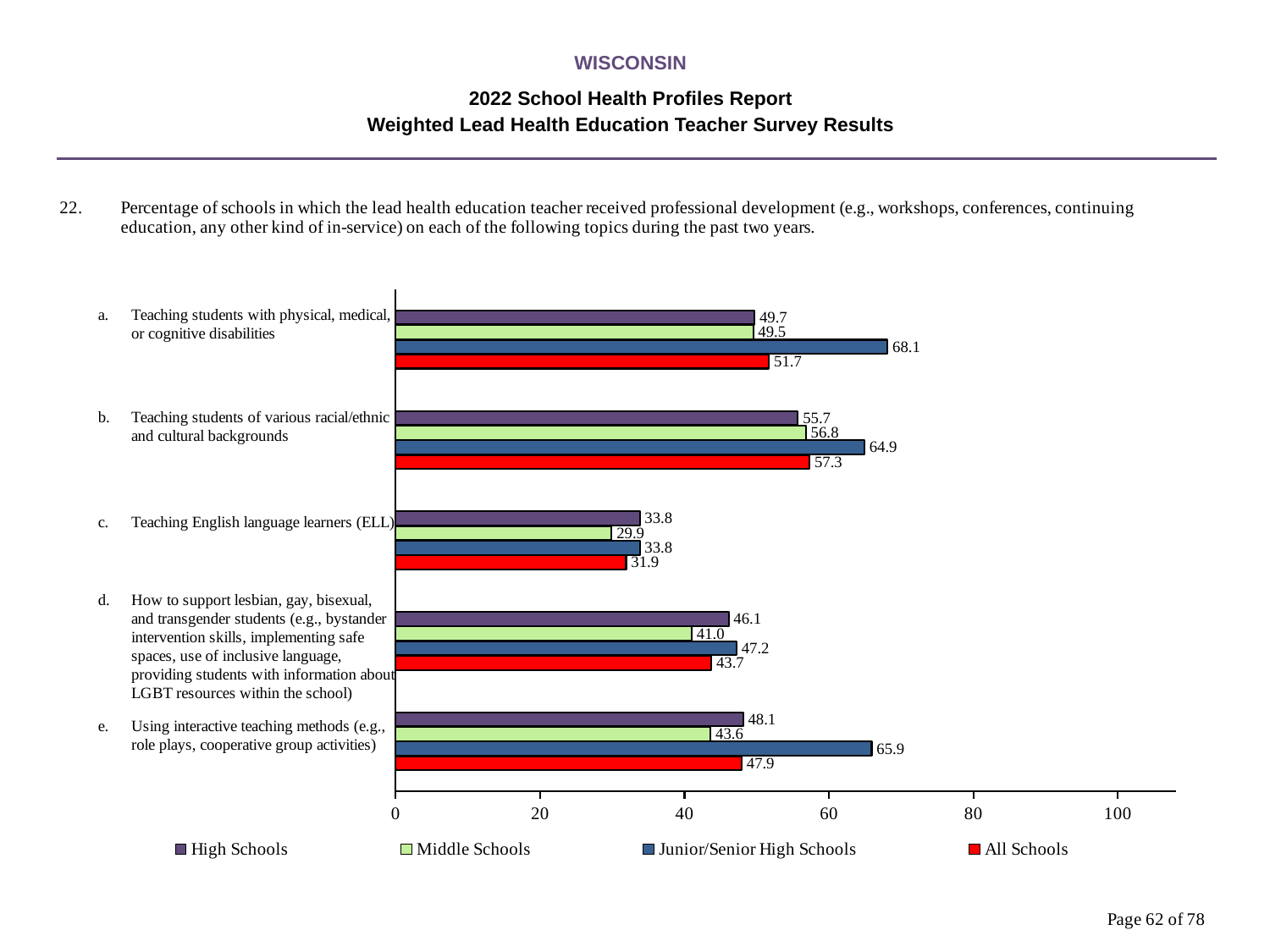
What is the value for Junior/Senior High Schools for topic a, teaching students with physical, medical, or cognitive disabilities? 68.1 Which topic has the highest value for Junior/Senior High Schools? Teaching students with physical, medical, or cognitive disabilities What is the value for Middle Schools for topic d, how to support lesbian, gay, bisexual, and transgender students? 41.0 For topic b, teaching students of various racial/ethnic and cultural backgrounds, which is larger: the High Schools value or the Middle Schools value? Middle Schools Which topic has the lowest value for All Schools? Teaching English language learners (ELL) How many topics are shown on the chart? 5 What is the difference between the Junior/Senior High Schools value and the Middle Schools value for topic e, using interactive teaching methods? 22.3 What is the value for High Schools for topic e, using interactive teaching methods? 48.1 What is the value for All Schools for topic c, teaching English language learners (ELL)? 31.9 Is the All Schools value for topic b, teaching students of various racial/ethnic and cultural backgrounds, greater or less than 40? greater What kind of chart is shown on the slide? Bar chart How many series does the legend list? 4